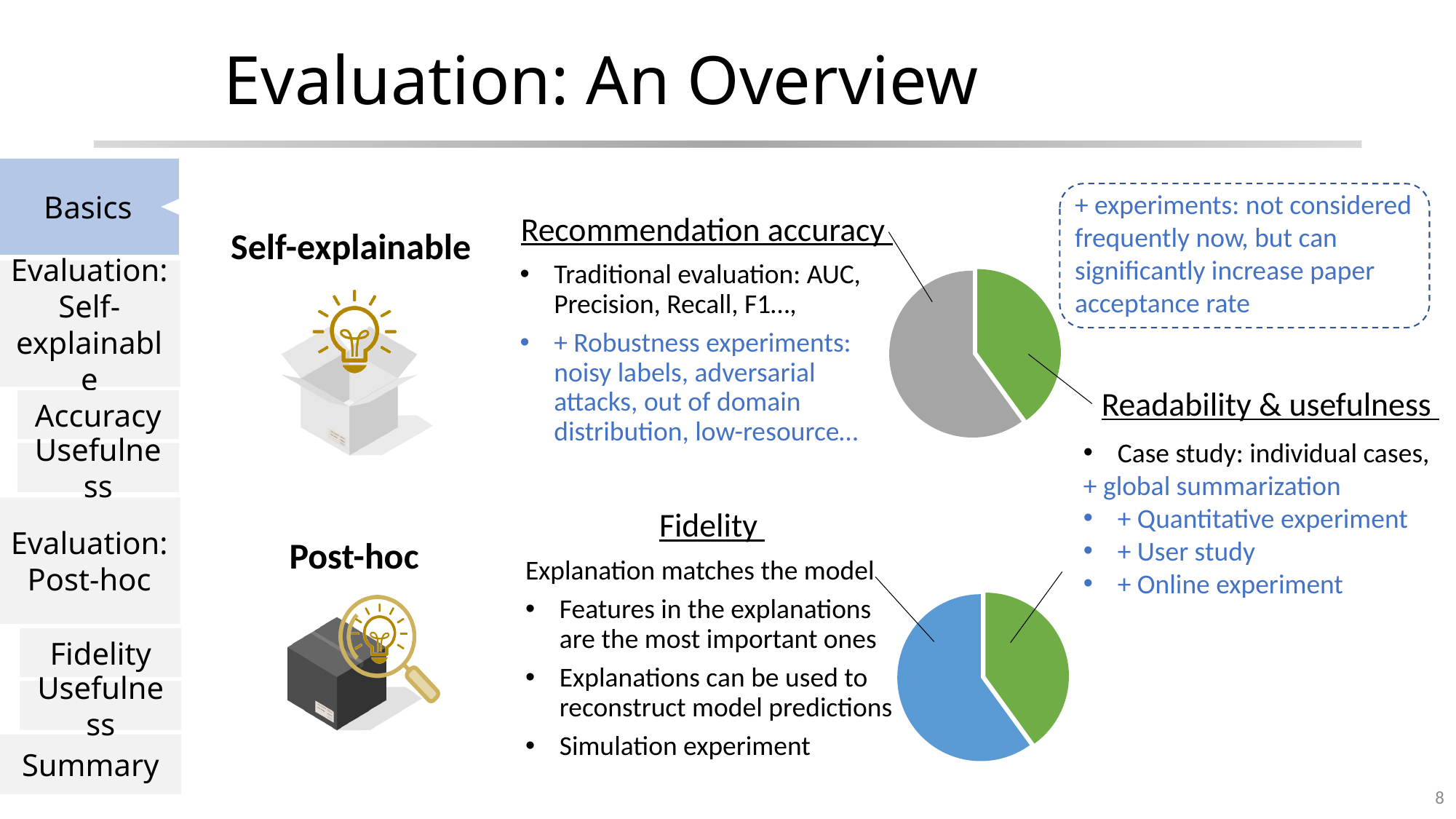
In the lower pie chart (Post-hoc), which category has the largest slice? Fidelity How many slices does the lower pie chart (Post-hoc) have? 2 In the upper pie chart (Self-explainable), which slice is larger: Recommendation accuracy or Readability & usefulness? Recommendation accuracy In the lower pie chart (Post-hoc), what colour is the Fidelity slice? blue In the lower pie chart (Post-hoc), which slice is larger: Fidelity or Readability & usefulness? Fidelity How many slices does the upper pie chart (Self-explainable) have? 2 In the upper pie chart (Self-explainable), what colour is the Recommendation accuracy slice? gray What kind of chart is the upper chart next to 'Self-explainable'? pie chart In the upper pie chart (Self-explainable), which category has the smallest slice? Readability & usefulness What kind of chart is the lower chart next to 'Post-hoc'? pie chart